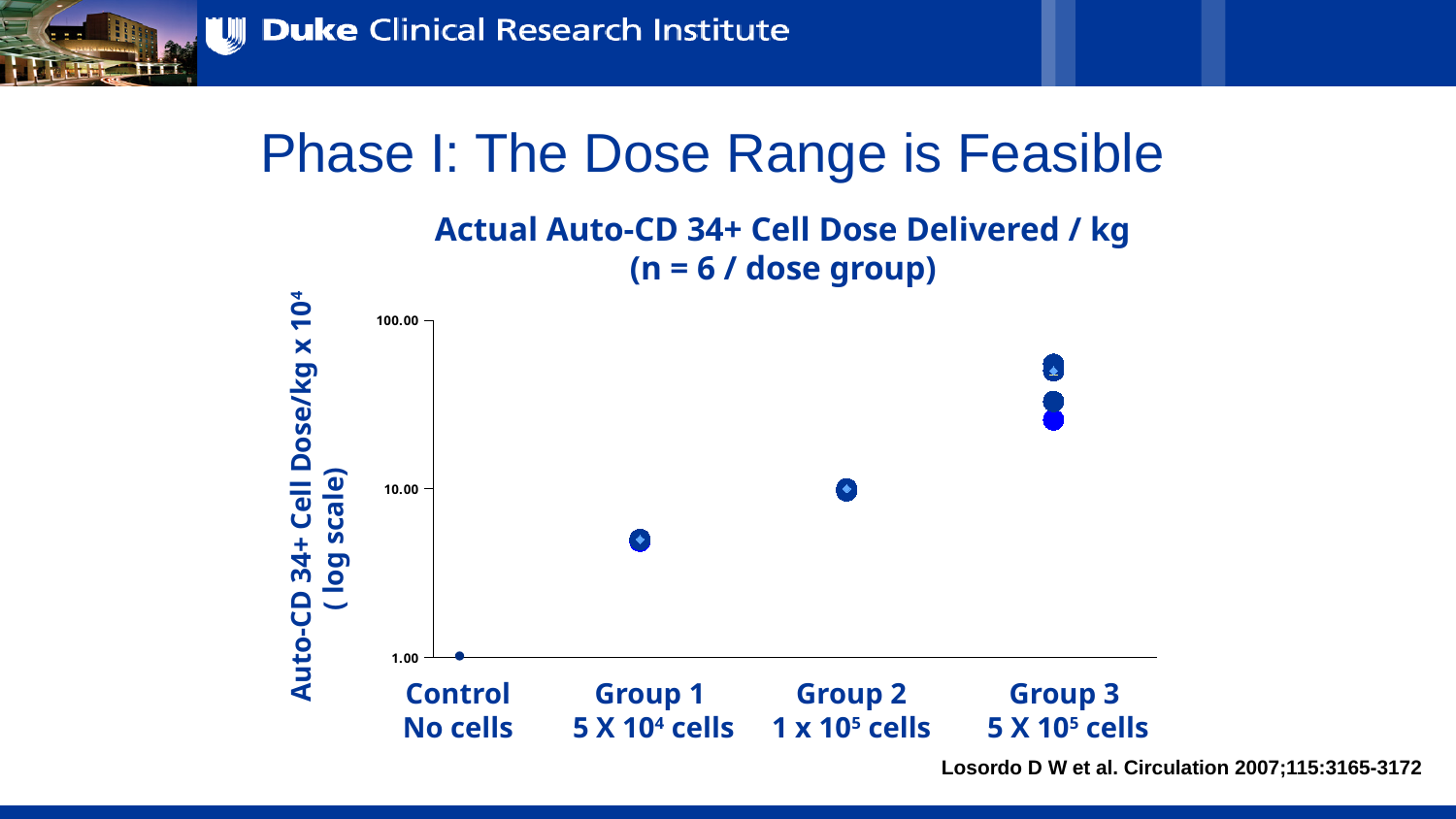
Which group has the lowest cell dose delivered per kg? Control How many dose groups are shown along the x axis of the chart? 4 Is the value for Group 1 greater or less than 10.00? less Do the values rise or fall moving from Control to Group 3 along the x axis? rise How many cells per kg were intended for Group 2 according to the x-axis label? 1 x 10^5 cells Is the value for Group 3 greater or less than 100.00? less What is the title of the chart? Actual Auto-CD 34+ Cell Dose Delivered / kg (n = 6 / dose group) Which group has the highest cell dose delivered per kg? Group 3 Is the value for Group 3 greater or less than 10.00? greater What is the label of the y axis of the chart? Auto-CD 34+ Cell Dose/kg x 10^4 (log scale) Which has a larger cell dose delivered per kg, Group 1 or Group 2? Group 2 What kind of chart is shown on the slide? Scatter chart